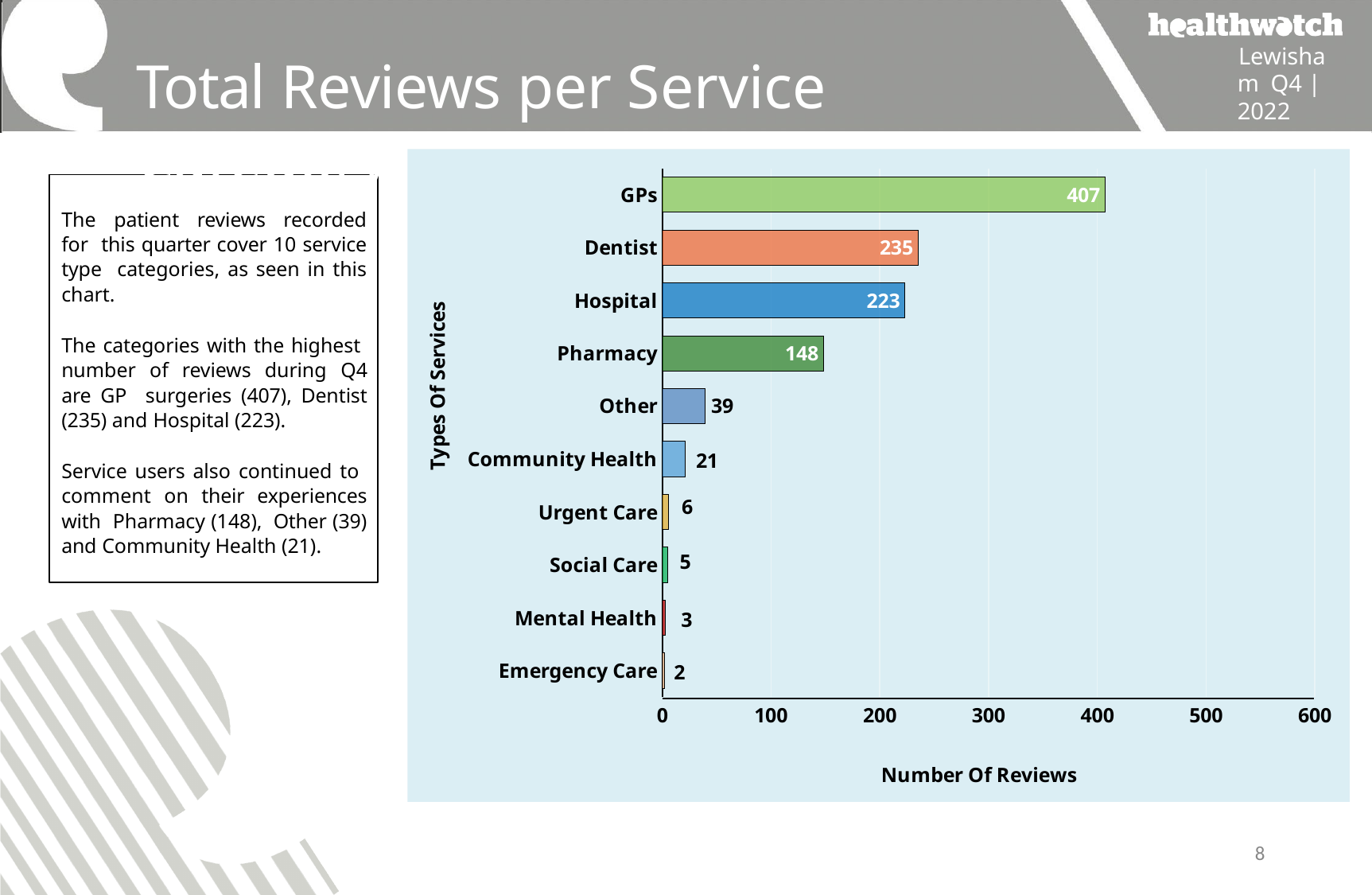
Which service type has the lowest number of reviews? Emergency Care Which has more reviews, Other or Community Health? Other What is the label of the horizontal axis of the chart? Number Of Reviews What is the difference in number of reviews between Dentist and Hospital? 12 What kind of chart is shown on the slide? Bar chart What is the number of reviews for Pharmacy? 148 How many more reviews did GPs receive than Pharmacy? 259 How many reviews does the Community Health bar show? 21 Which service type has the highest number of reviews? GPs Is the number of reviews for Hospital greater or less than 200? greater How many reviews were recorded for GPs? 407 How many service type categories are shown in the chart? 10